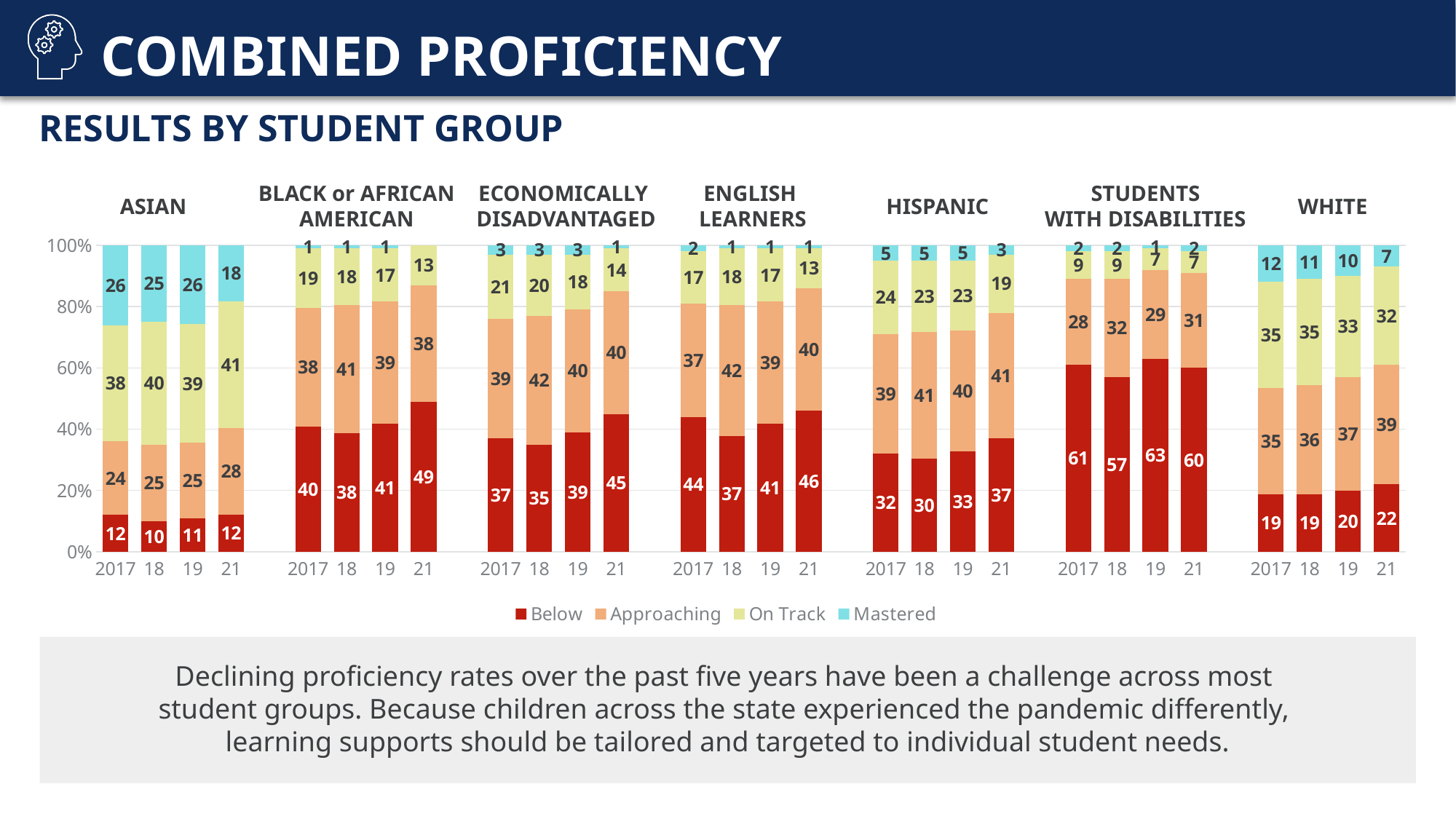
How many student groups are shown in the chart? 7 Does the Mastered value for White students rise or fall from 2017 to 21? Fall What is the Mastered value for White students in 21? 7 For Asian students, which year has the lowest Below value? 18 What kind of chart is shown on the slide? Stacked bar chart What is the Below value for Students with Disabilities in 19? 63 How much higher is the Below value for Black or African American students in 21 than in 2017? 9 What percentage of Asian students were in the Below category in 2017? 12 In 21, which group has the larger Approaching value: White or Asian? White What is the On Track value for Economically Disadvantaged students in 19? 18 For Hispanic students, which year has the highest Below value? 21 How many series does the legend list? 4